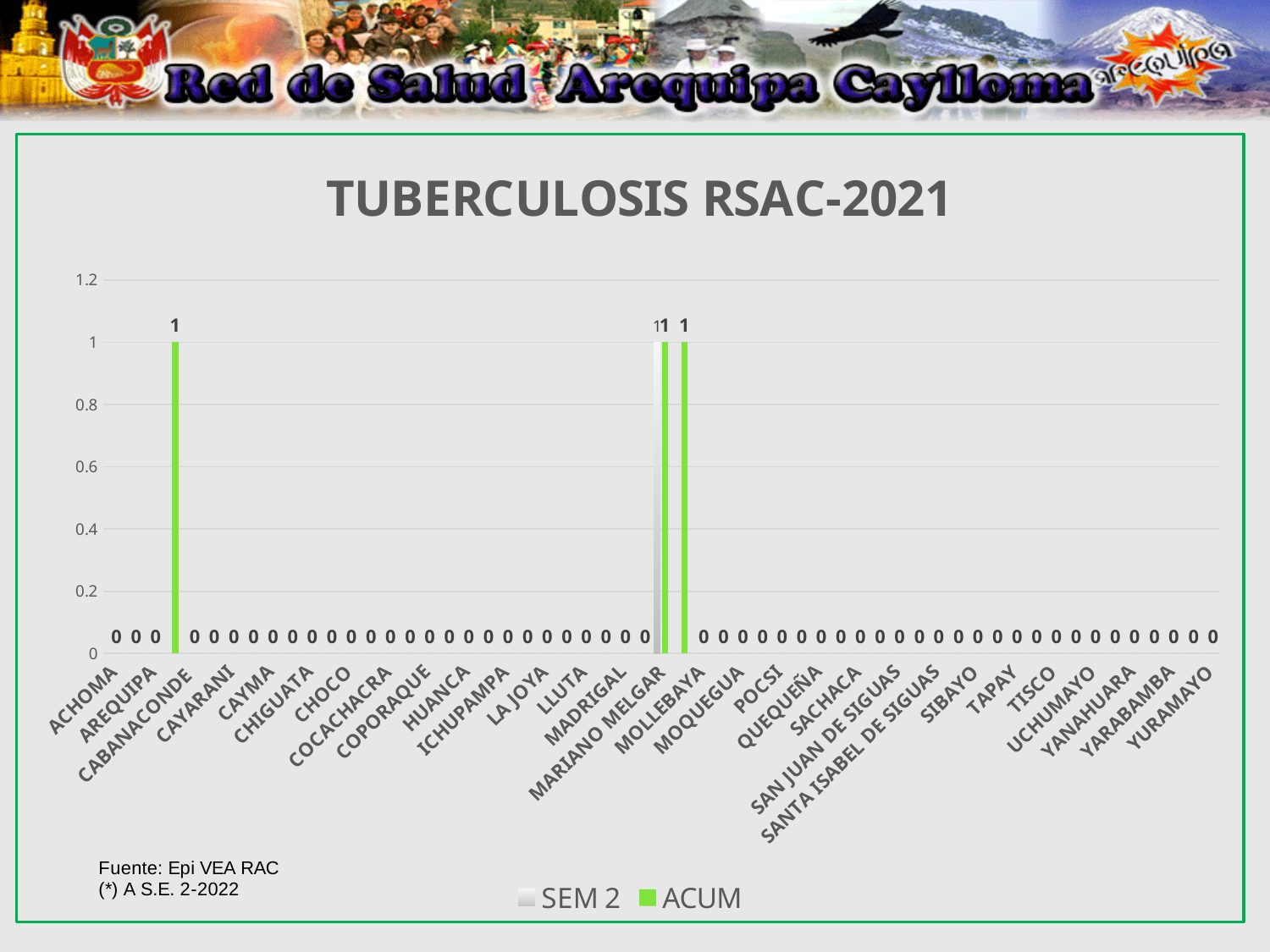
What is the maximum value shown on the vertical axis? 1.2 What is the ACUM value for YURAMAYO? 0 What is the ACUM value for CABANACONDE? 0 What is the highest value plotted in the chart? 1 What is the SEM 2 value for MARIANO MELGAR? 1 What is the ACUM value for ACHOMA? 0 What are the two series named in the legend? SEM 2 and ACUM What kind of chart is shown on the slide? bar chart What is the difference between the ACUM value for CABANACONDE and the ACUM value for ACHOMA? 0 How many series does the legend list? 2 Which is larger, the ACUM value for CABANACONDE or the ACUM value for CAYARANI? Neither; both are 0 What is the title of the chart? TUBERCULOSIS RSAC-2021